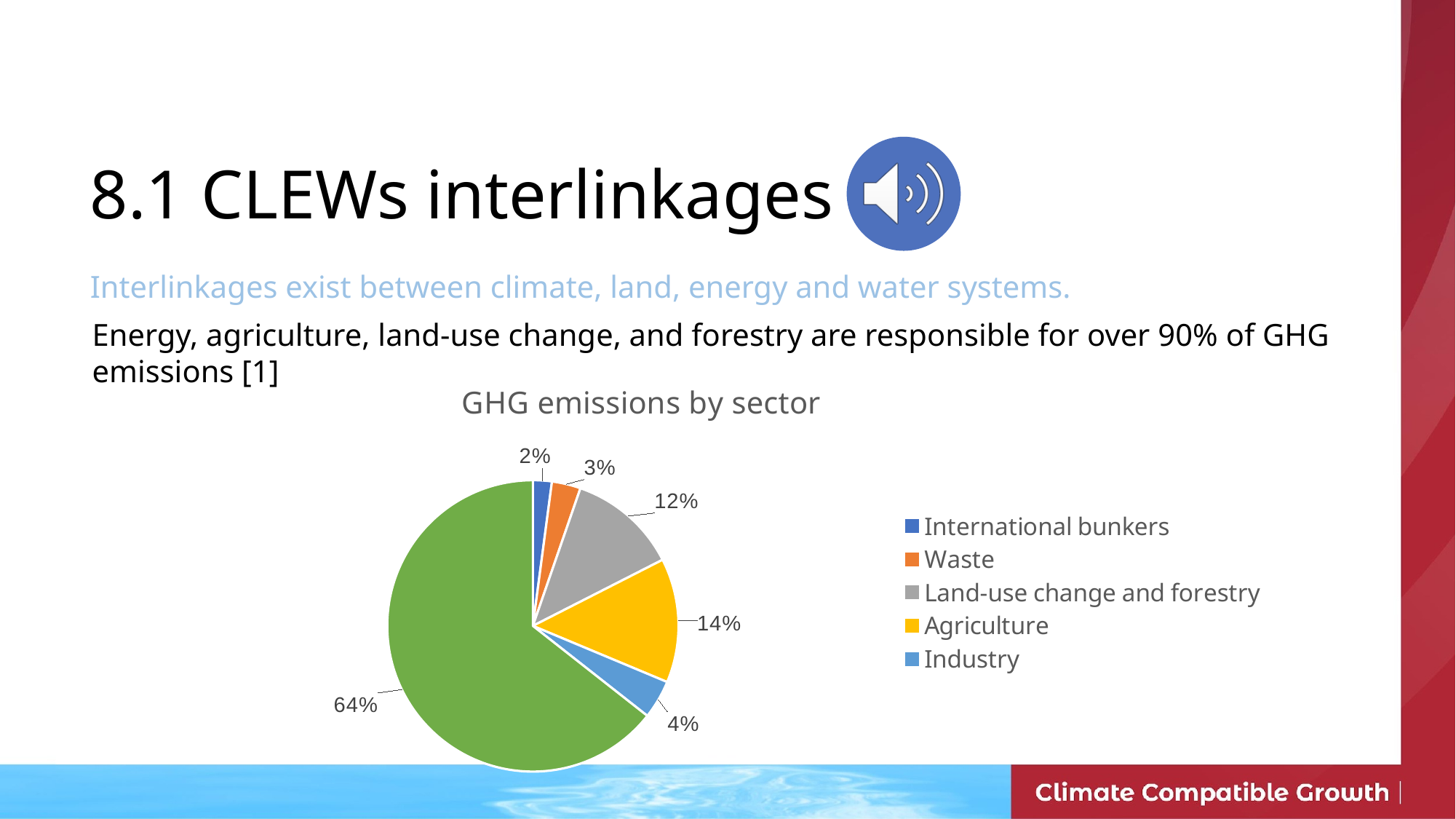
What share of GHG emissions does Land-use change and forestry account for? 12% What share of GHG emissions does International bunkers account for? 2% What is the difference between the Agriculture share and the Industry share? 10% How many entries does the legend list? 5 What share of GHG emissions does Waste account for? 3% What is the title of the chart? GHG emissions by sector What share of GHG emissions does Industry account for? 4% What type of chart is shown on the slide? pie chart Which is larger, the Agriculture slice or the Land-use change and forestry slice? Agriculture Which of the legend entries has the smallest slice? International bunkers What share of GHG emissions does Agriculture account for? 14% What percentage is shown for the largest slice of the pie? 64%